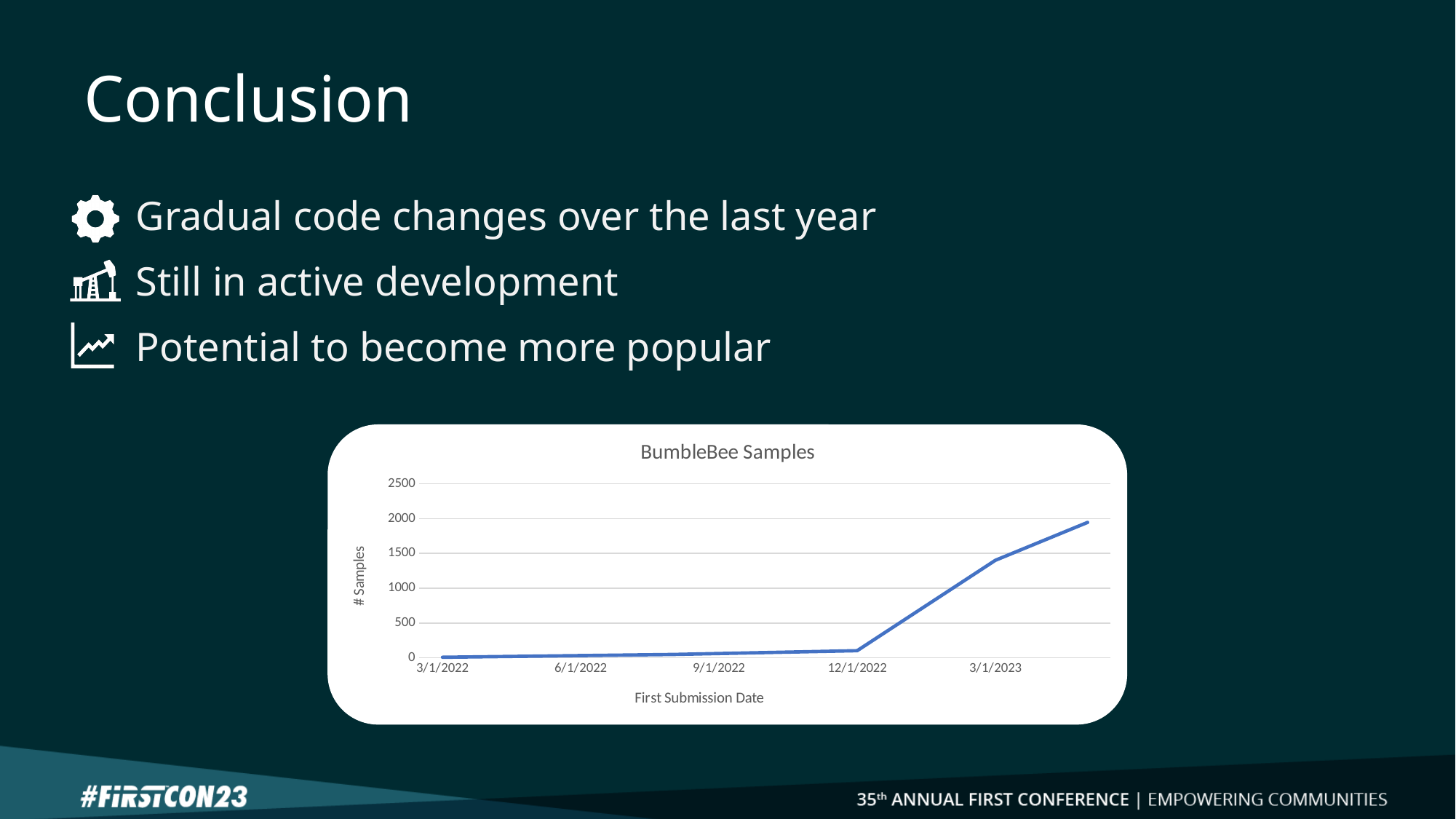
Which is larger, the value for 3/1/2023 or the value for 12/1/2022? 3/1/2023 Is the value for 3/1/2023 greater or less than 1000? greater Is the value for 9/1/2022 greater or less than 500? less Is the value for 12/1/2022 greater or less than 500? less What is the label of the x axis of the chart? First Submission Date What is the highest value shown on the y axis of the chart? 2500 How many date labels are shown on the x axis of the chart? 5 Do the values in the BumbleBee Samples chart rise or fall along the x axis? rise Which is larger, the value for 3/1/2022 or the value for 3/1/2023? 3/1/2023 What kind of chart is shown on the slide? line chart What is the title of the chart? BumbleBee Samples